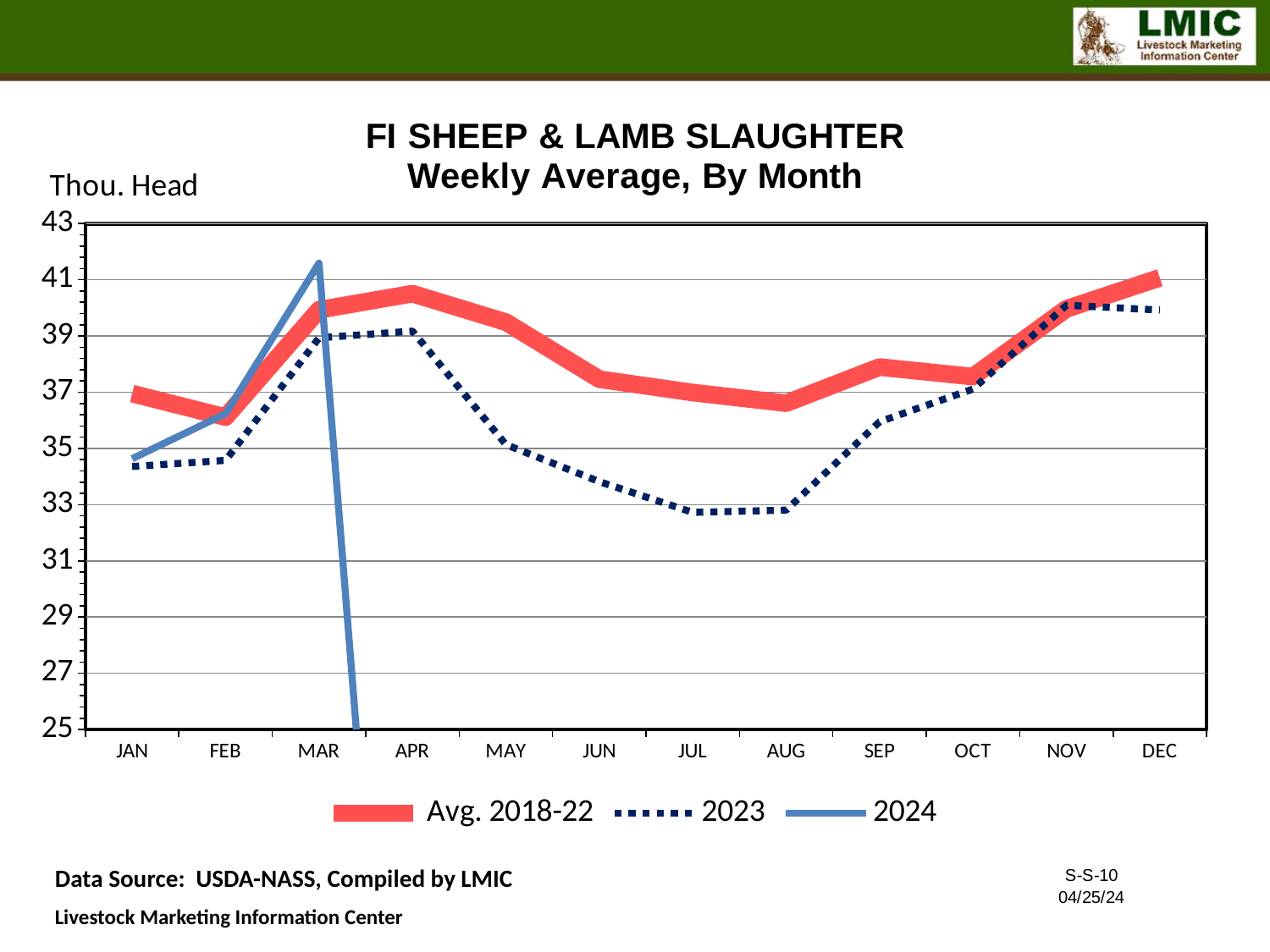
In JUL, which series is higher: Avg. 2018-22 or 2023? Avg. 2018-22 How many months are shown along the x axis? 12 Is the Avg. 2018-22 value for DEC greater or less than 39? greater Is the 2024 value for MAR greater or less than 39? greater Is the 2023 value for JAN greater or less than 35? less How many series does the legend list? 3 Does the 2023 series rise or fall from APR to JUL? fall In which month does the 2024 series reach its highest value? MAR What kind of chart is shown on the slide? line chart What is the title of the chart? FI SHEEP & LAMB SLAUGHTER Weekly Average, By Month What unit label is shown on the y axis? Thou. Head